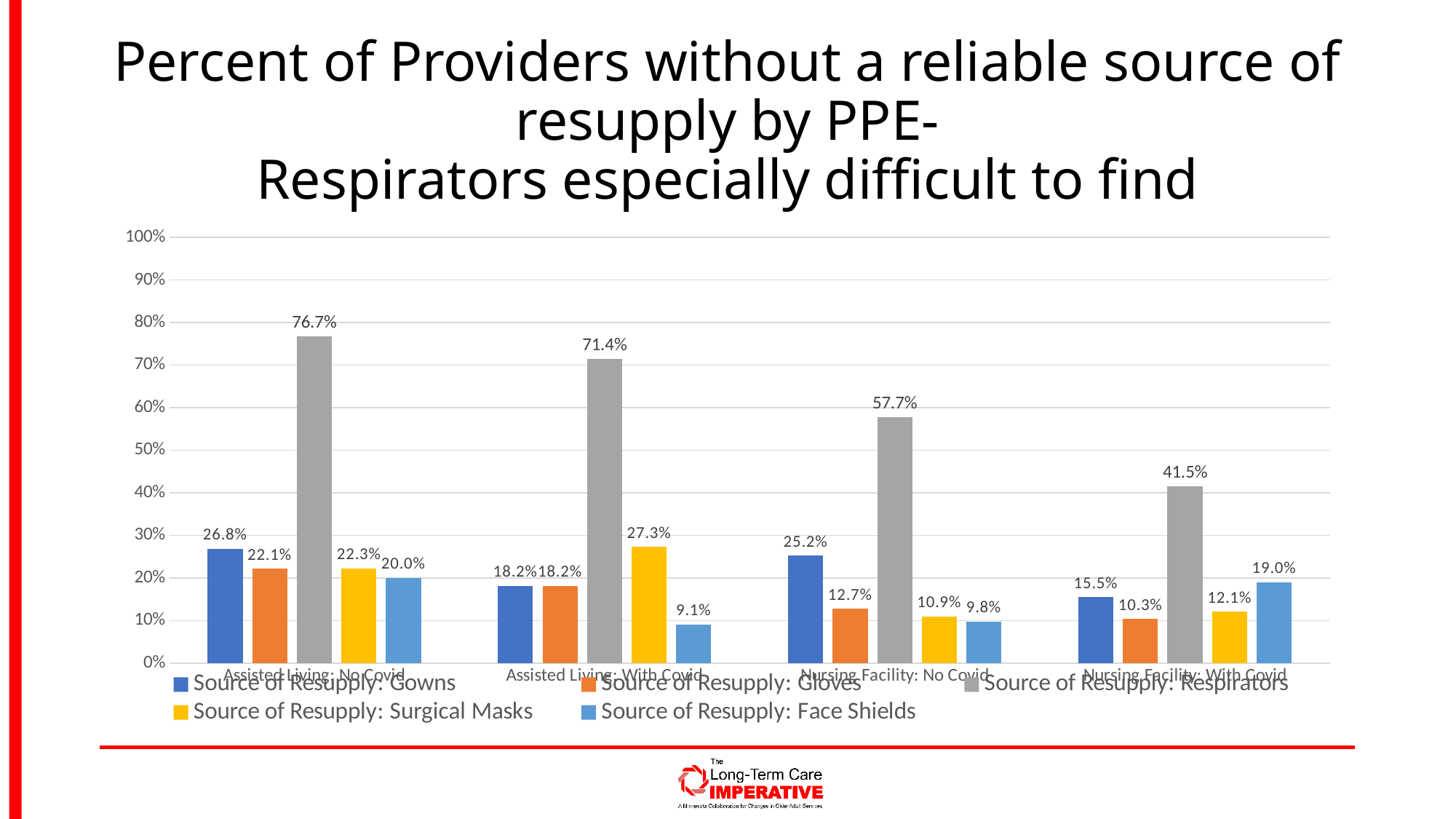
Is the Respirators value for Nursing Facility: No Covid greater or less than 50%? greater What is the value for Surgical Masks in the Assisted Living: With Covid category? 27.3% What is the difference between the Respirators values for Assisted Living: No Covid and Nursing Facility: With Covid? 35.2% Which is larger in the Nursing Facility: No Covid category, Gowns or Gloves? Gowns How many series does the legend list? 5 Which category has the lowest Gloves value? Nursing Facility: With Covid Which series is shown in gray in the legend? Source of Resupply: Respirators How many provider categories are shown along the x axis? 4 What type of chart is shown on the slide? Bar chart What is the value for Respirators in the Assisted Living: No Covid category? 76.7% Which category has the highest Respirators value? Assisted Living: No Covid What is the value for Face Shields in the Nursing Facility: With Covid category? 19.0%